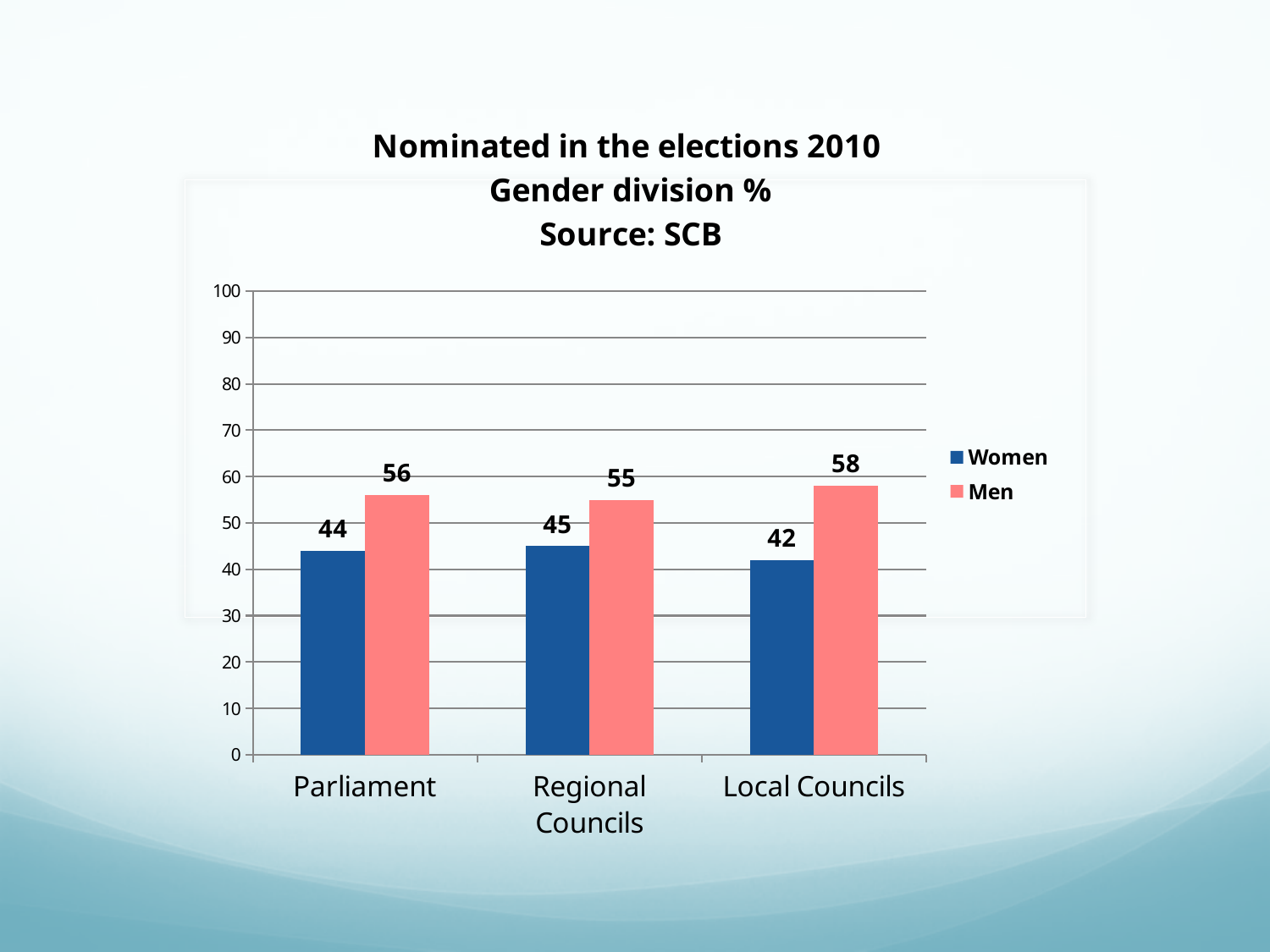
What source is cited in the chart title? SCB What is the value for Women in Parliament? 44 What is the difference between Men and Women in Parliament? 12 Is the value for Men in Local Councils greater or less than 50? greater What is the value for Men in Local Councils? 58 What is the value for Women in Regional Councils? 45 What kind of chart is shown on the slide? bar chart Which category has the highest value for Men? Local Councils How many series does the legend list? 2 How many categories are shown on the x axis? 3 Which category has the lowest value for Women? Local Councils Which is larger in Regional Councils, Women or Men? Men